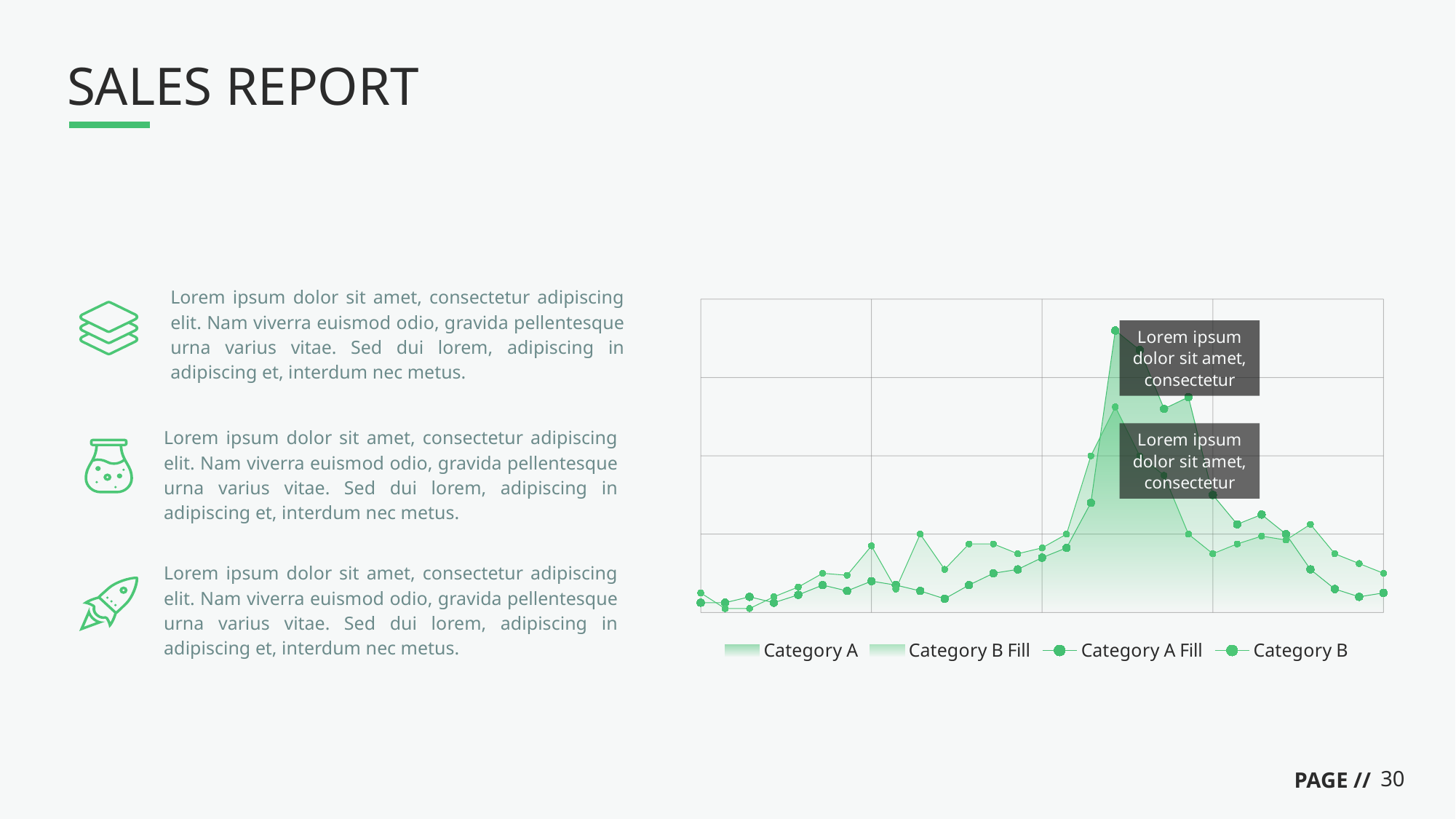
What are the four entries listed in the chart legend? Category A, Category B Fill, Category A Fill, Category B Do the plotted values generally rise or fall from the left edge of the chart up to the peak? rise Does the chart show a sharp peak in the right half or the left half of the x axis? right half What is the title of the slide containing the chart? SALES REPORT How many series does the chart legend list? 4 What kind of chart is shown on the slide? line chart with shaded area fills After the peak, do the plotted values rise or fall toward the right edge of the chart? fall